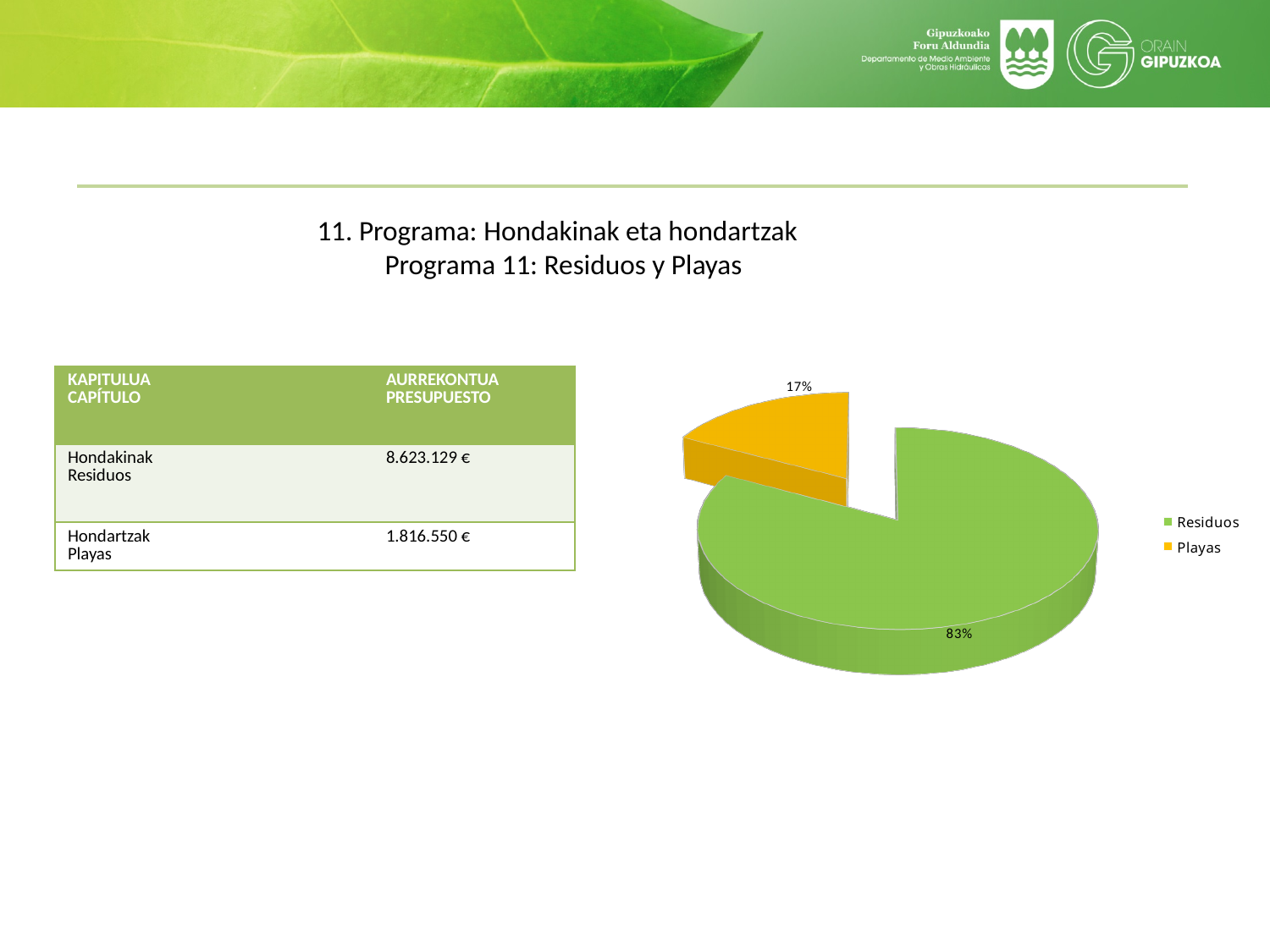
What colour is the Residuos slice in the pie chart? green Which slice of the pie is the smallest? Playas What share of the pie does Playas represent? 17% How many slices does the pie chart have? 2 What share of the pie does Residuos represent? 83% Which slice of the pie is the largest? Residuos What kind of chart is shown on the slide? pie chart Which is larger, the share for Residuos or the share for Playas? Residuos What colour is the Playas slice in the pie chart? yellow/orange What is the difference in percentage points between the Residuos share and the Playas share? 66 How many entries does the legend list? 2